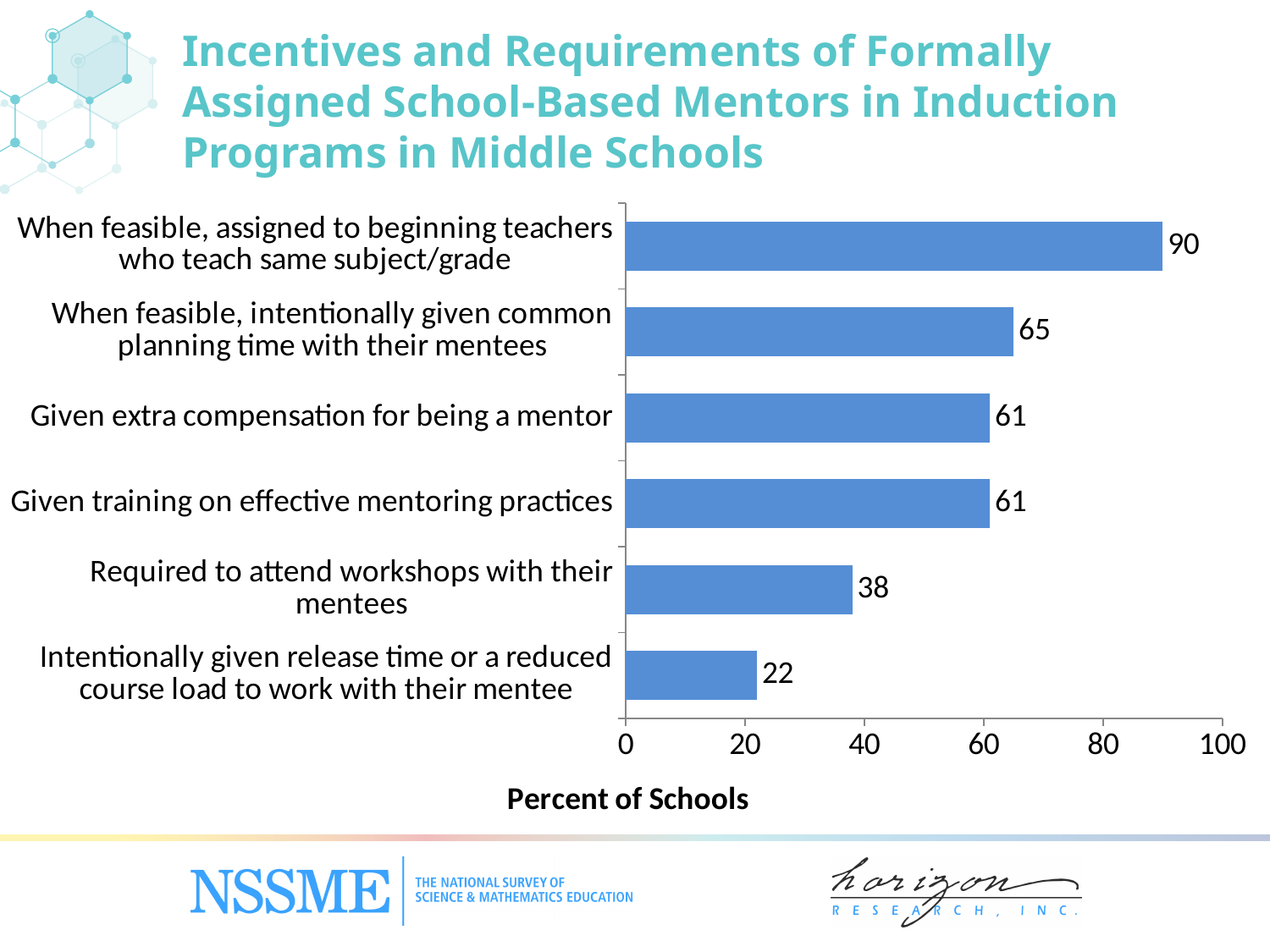
How many categories are shown in the chart? 6 Which category has the highest value? When feasible, assigned to beginning teachers who teach same subject/grade What is the difference between the highest and lowest values in the chart? 68 What is the label of the horizontal axis? Percent of Schools Which category has the lowest value? Intentionally given release time or a reduced course load to work with their mentee What percent of schools report that mentors are, when feasible, assigned to beginning teachers who teach the same subject/grade? 90 Is the value for 'Intentionally given release time or a reduced course load to work with their mentee' greater or less than 40? less What kind of chart is shown on the slide? Bar chart What is the difference between the value for 'When feasible, intentionally given common planning time with their mentees' and the value for 'Required to attend workshops with their mentees'? 27 Which is larger: the value for 'When feasible, intentionally given common planning time with their mentees' or the value for 'Given training on effective mentoring practices'? When feasible, intentionally given common planning time with their mentees What percent of schools require mentors to attend workshops with their mentees? 38 What is the value for 'Given extra compensation for being a mentor'? 61